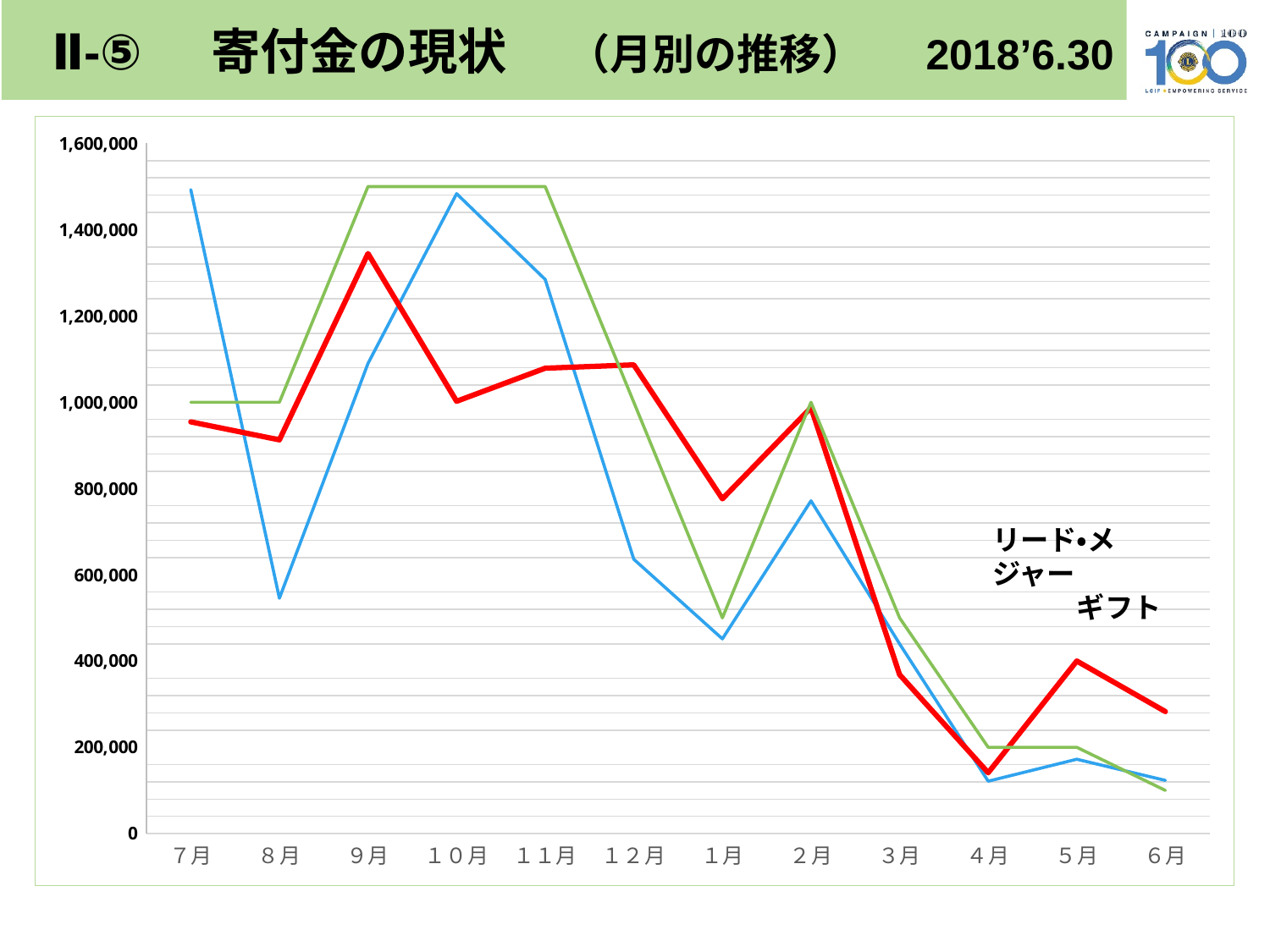
Is the value of the green line in 6月 greater or less than 200,000? less Is the value of the blue line in 10月 greater or less than 1,400,000? greater In 7月, which line has the larger value, the blue line or the red line? blue line Is the value of the blue line in 8月 greater or less than 600,000? less What kind of chart is shown on the slide? line chart What date is shown in the slide title? 2018’6.30 In which month does the red line reach its lowest value? 4月 How many months are plotted along the x axis? 12 In which month does the red line reach its highest value? 9月 In 12月, which line has the larger value, the red line or the blue line? red line Does the red line rise or fall from 2月 to 4月? fall